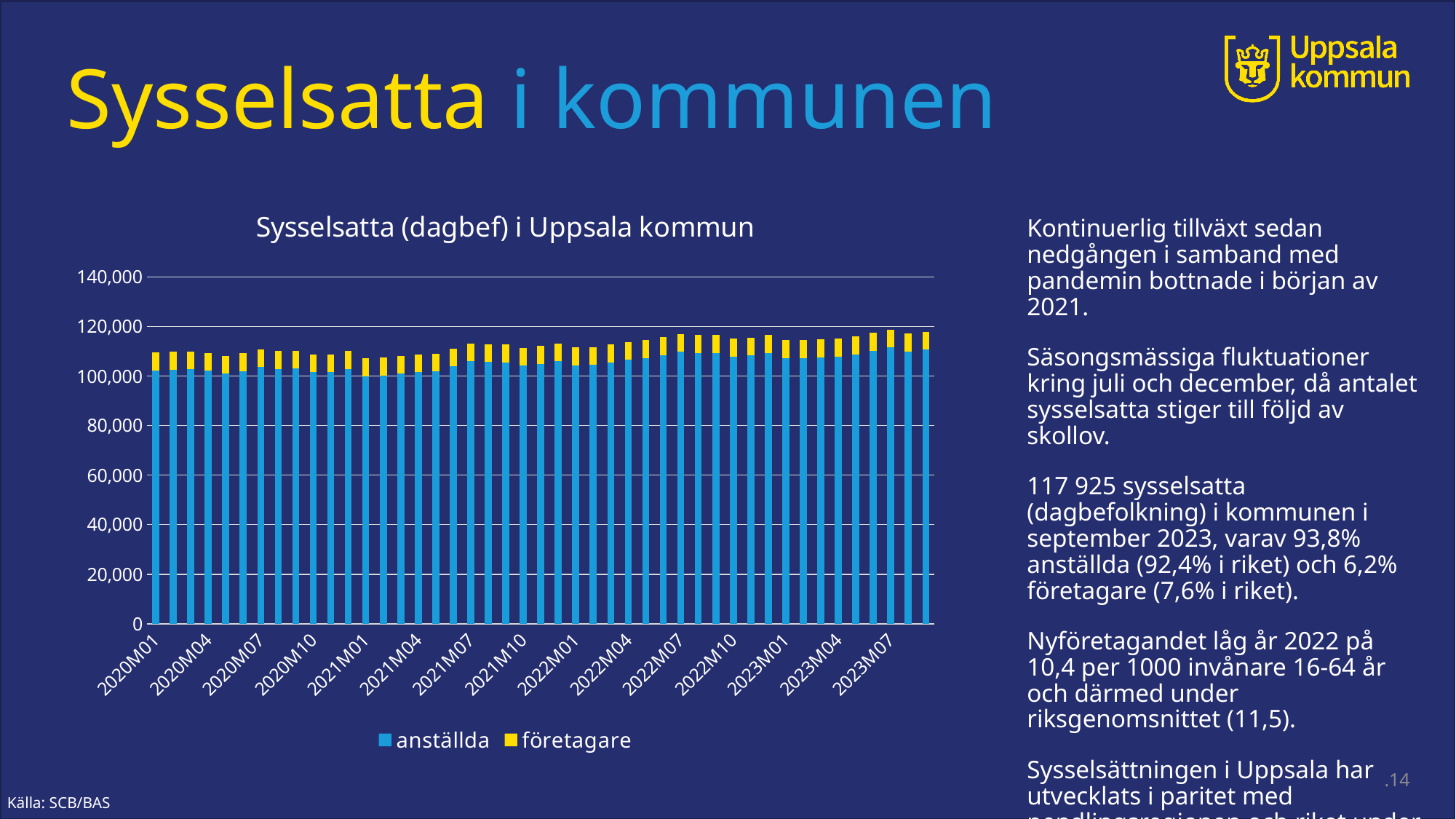
Is the value for anställda in 2023M07 greater or less than 100,000? greater What kind of chart is shown on the slide? Stacked bar chart Is the value for företagare in 2023M07 greater or less than 20,000? less What is the title of the chart? Sysselsatta (dagbef) i Uppsala kommun How many month labels are shown on the x axis of the chart? 15 Is the total stacked value for 2020M01 greater or less than 120,000? less What are the two series named in the chart legend? anställda and företagare Which series has the larger value in every bar, anställda or företagare? anställda Is the value for anställda larger in 2021M01 or in 2023M07? 2023M07 How many series does the chart legend list? 2 Do the total stacked values generally rise or fall from 2021M01 to 2023M07? rise